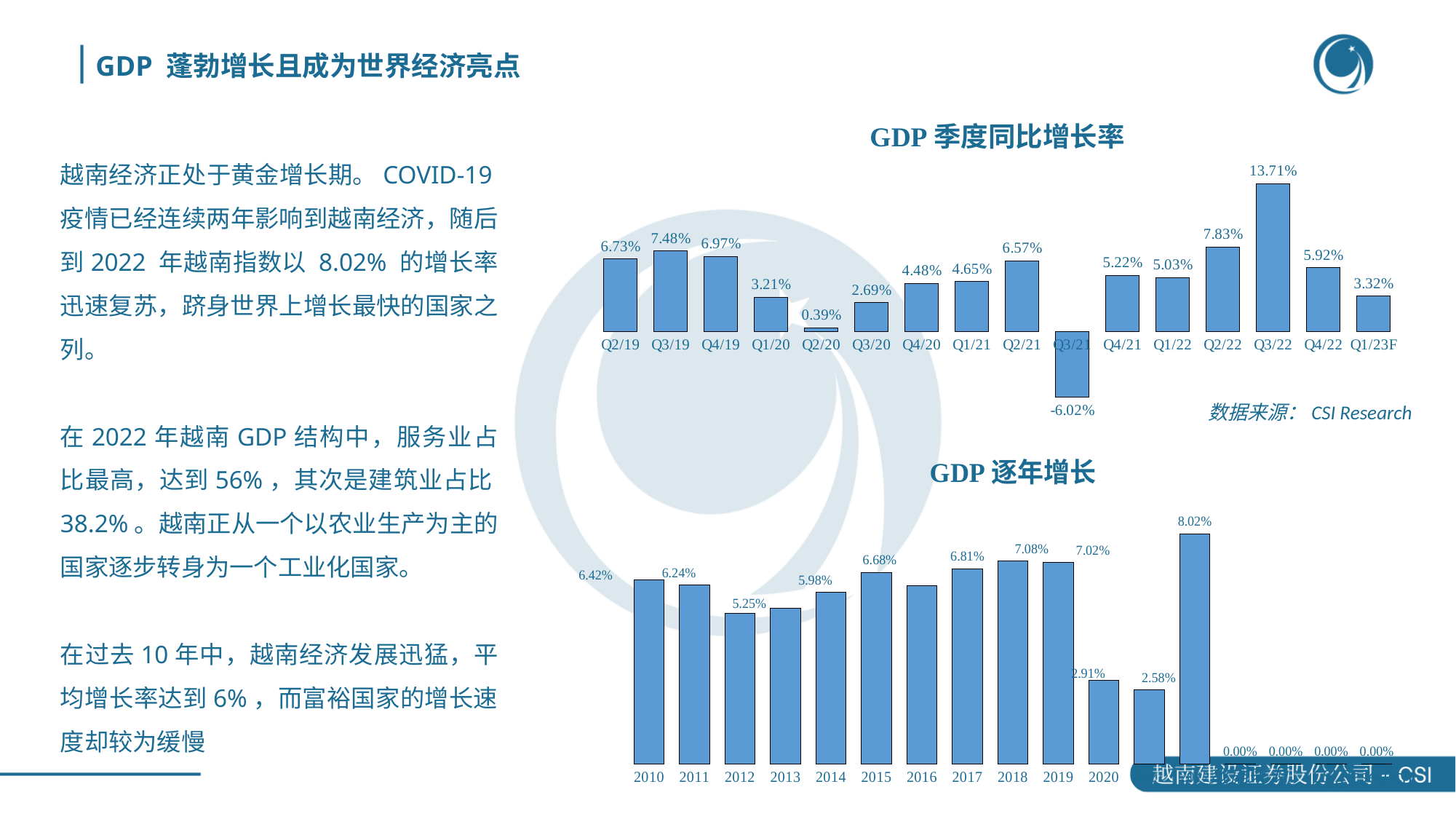
In the GDP 季度同比增长率 chart, which quarter has the highest value? Q3/22 In the GDP 季度同比增长率 chart, what is the value for Q2/20? 0.39% What kind of chart is the GDP 逐年增长 chart? Bar chart In the GDP 逐年增长 chart, what is the value of the tallest bar? 8.02% How many quarters are shown on the x axis of the GDP 季度同比增长率 chart? 16 In the GDP 逐年增长 chart, what is the value for 2018? 7.08% In the GDP 季度同比增长率 chart, which is larger, the value for Q3/19 or the value for Q4/19? Q3/19 In the GDP 季度同比增长率 chart, which quarter has the lowest value? Q3/21 What is the data source stated below the GDP 季度同比增长率 chart? CSI Research In the GDP 季度同比增长率 chart, what is the value for Q3/22? 13.71% In the GDP 季度同比增长率 chart, what is the difference between the values for Q2/22 and Q1/22? 2.80% In the GDP 逐年增长 chart, what is the value for 2020? 2.91%